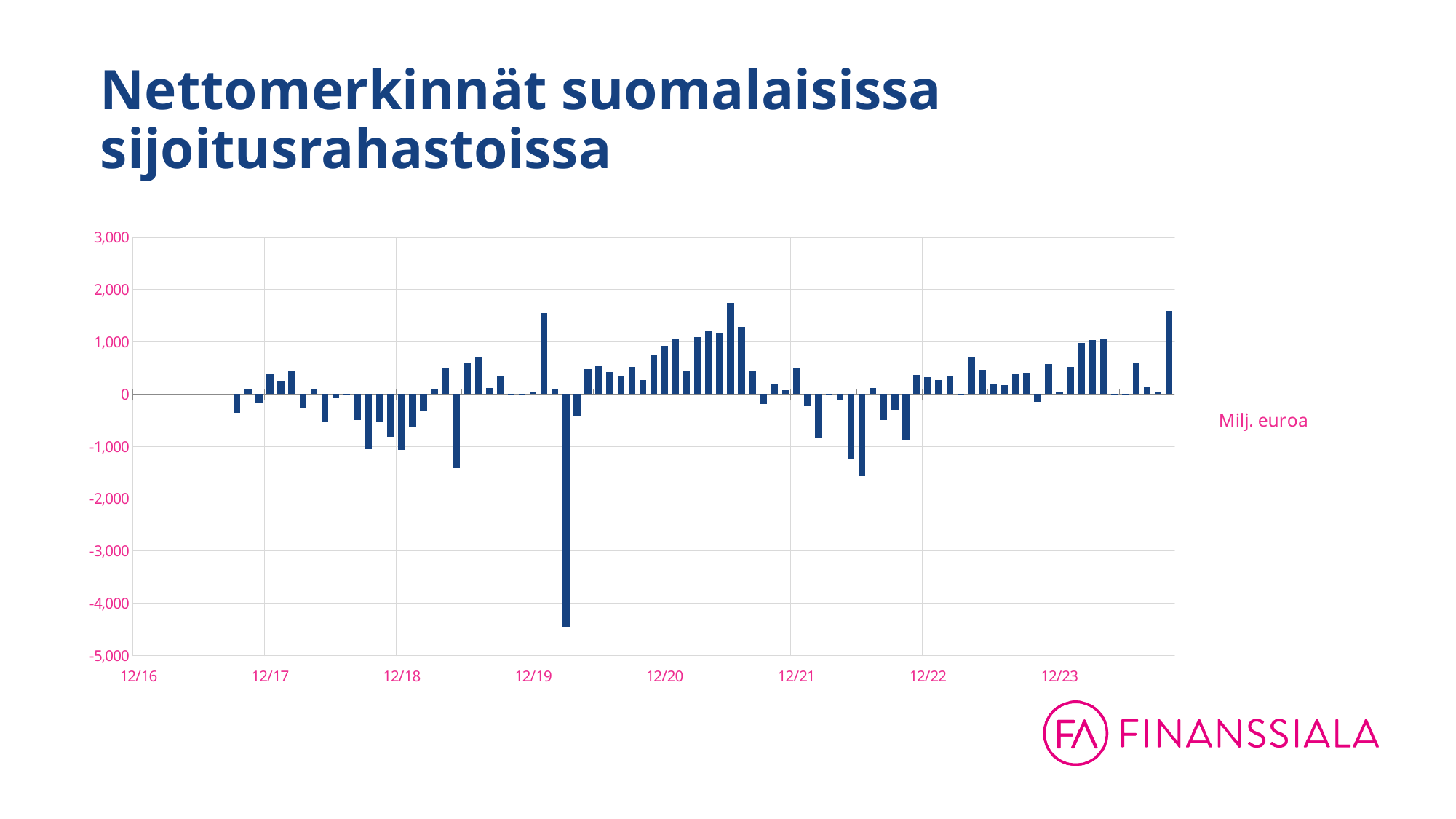
Between which two x-axis labels does the lowest bar in the chart fall? 12/19 and 12/20 What kind of chart is shown on the slide? bar chart Is the value of the highest bar in the chart greater or less than 2,000? less Is the value of the bar at 12/19 greater or less than 1,000? less Is the value of the highest bar in the chart greater or less than 1,000? greater How many labels are shown on the x axis? 8 What is the lowest value shown on the y axis? -5,000 What is the title of the chart? Nettomerkinnät suomalaisissa sijoitusrahastoissa What unit is indicated next to the chart? Milj. euroa